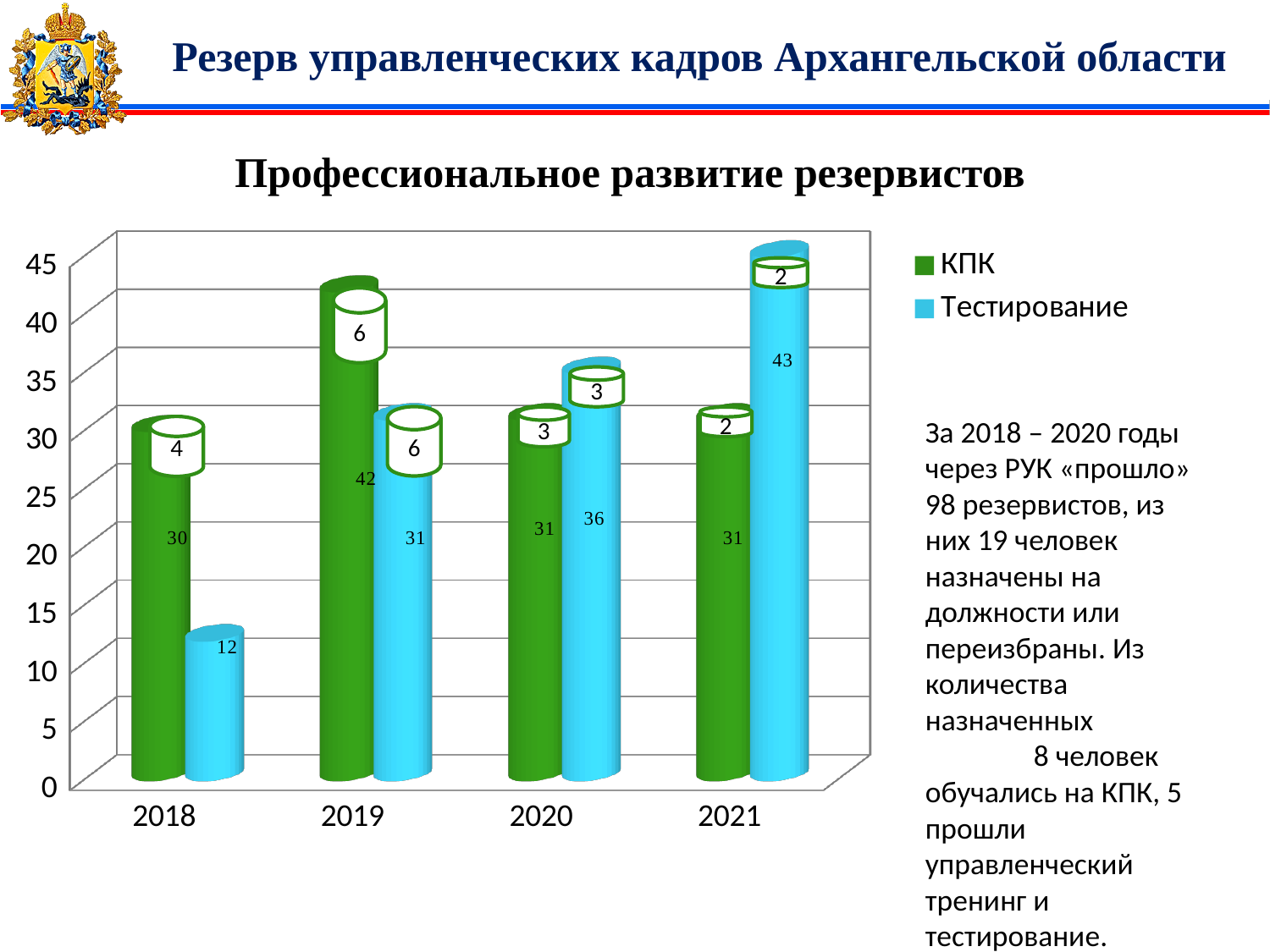
How many series does the legend list? 2 In which year is the КПК value highest? 2019 What is the value for КПК in 2018? 30 What is the value for Тестирование in 2018? 12 Which is larger in 2020, КПК or Тестирование? Тестирование What is the value for Тестирование in 2021? 43 What is the value for КПК in 2019? 42 How many years are shown on the x axis? 4 Does the Тестирование value rise or fall from 2018 to 2021? rise What is the difference between the КПК and Тестирование values in 2018? 18 In which year is the Тестирование value lowest? 2018 What kind of chart is shown on the slide? bar chart